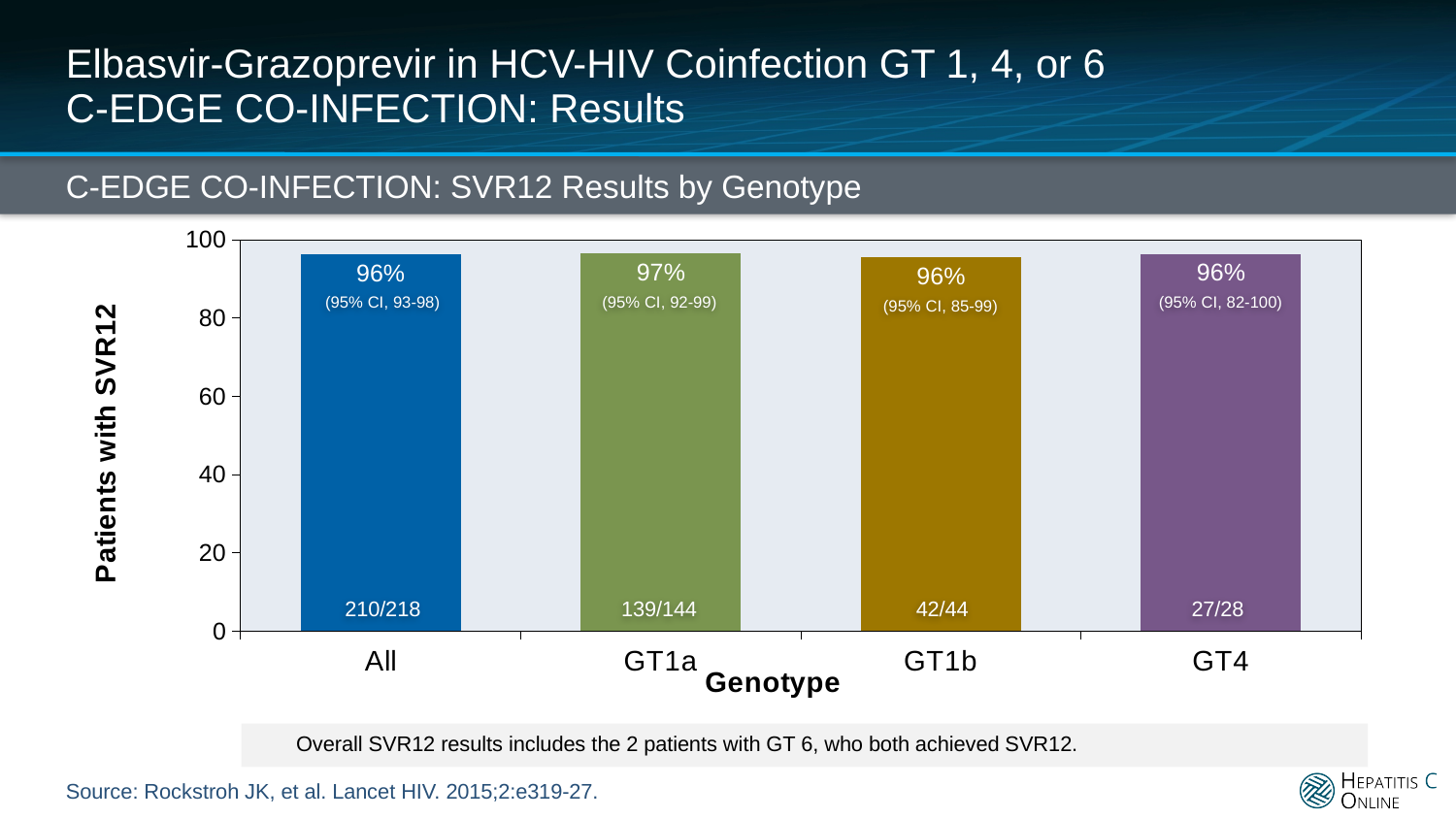
What is the label of the y axis? Patients with SVR12 What is the difference in SVR12 rate between GT1a and GT1b? 1% What kind of chart is shown on the slide? Bar chart What fraction of patients achieved SVR12 in the GT1b group? 42/44 What is the SVR12 rate for the GT4 group? 96% Is the SVR12 rate for GT1b greater or less than 80? greater What is the SVR12 rate for the GT1a group? 97% What is the 95% confidence interval shown for the GT4 group? 82-100 How many genotype categories are shown on the x axis? 4 What is the SVR12 rate for the All group? 96% Which genotype group has the highest SVR12 rate? GT1a What fraction of patients achieved SVR12 in the All group? 210/218